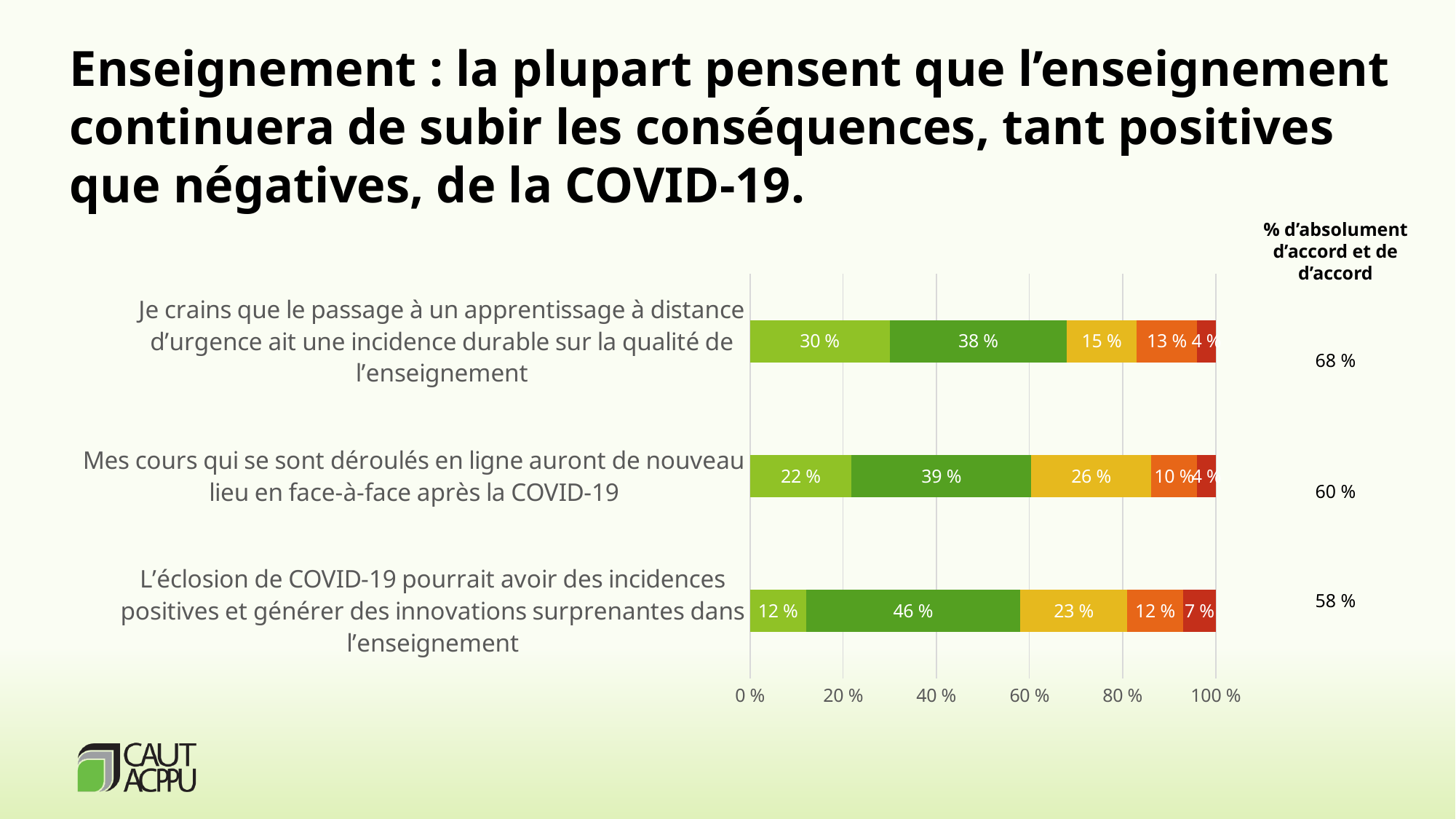
What is the value of the dark green (second) segment for the statement 'L'éclosion de COVID-19 pourrait avoir des incidences positives et générer des innovations surprenantes dans l'enseignement'? 46 % What is the value of the light green (first) segment for the statement 'Je crains que le passage à un apprentissage à distance d'urgence ait une incidence durable sur la qualité de l'enseignement'? 30 % What is the '% d'absolument d'accord et de d'accord' shown for the statement 'Mes cours qui se sont déroulés en ligne auront de nouveau lieu en face-à-face après la COVID-19'? 60 % How many statements (categories) are plotted in the chart? 3 Which statement has the lowest '% d'absolument d'accord et de d'accord'? L'éclosion de COVID-19 pourrait avoir des incidences positives et générer des innovations surprenantes dans l'enseignement What kind of chart is shown on the slide? stacked bar chart What is the value of the yellow (third) segment for the statement 'Mes cours qui se sont déroulés en ligne auront de nouveau lieu en face-à-face après la COVID-19'? 26 % How many coloured segments make up each bar in the chart? 5 Which statement has the highest '% d'absolument d'accord et de d'accord'? Je crains que le passage à un apprentissage à distance d'urgence ait une incidence durable sur la qualité de l'enseignement Which statement has the larger dark green (second) segment: 'Je crains que le passage à un apprentissage à distance...' or 'L'éclosion de COVID-19 pourrait avoir des incidences positives...'? L'éclosion de COVID-19 pourrait avoir des incidences positives et générer des innovations surprenantes dans l'enseignement What is the difference between the highest and lowest '% d'absolument d'accord et de d'accord' values shown? 10 % What is the value of the red (last) segment for the statement 'L'éclosion de COVID-19 pourrait avoir des incidences positives et générer des innovations surprenantes dans l'enseignement'? 7 %